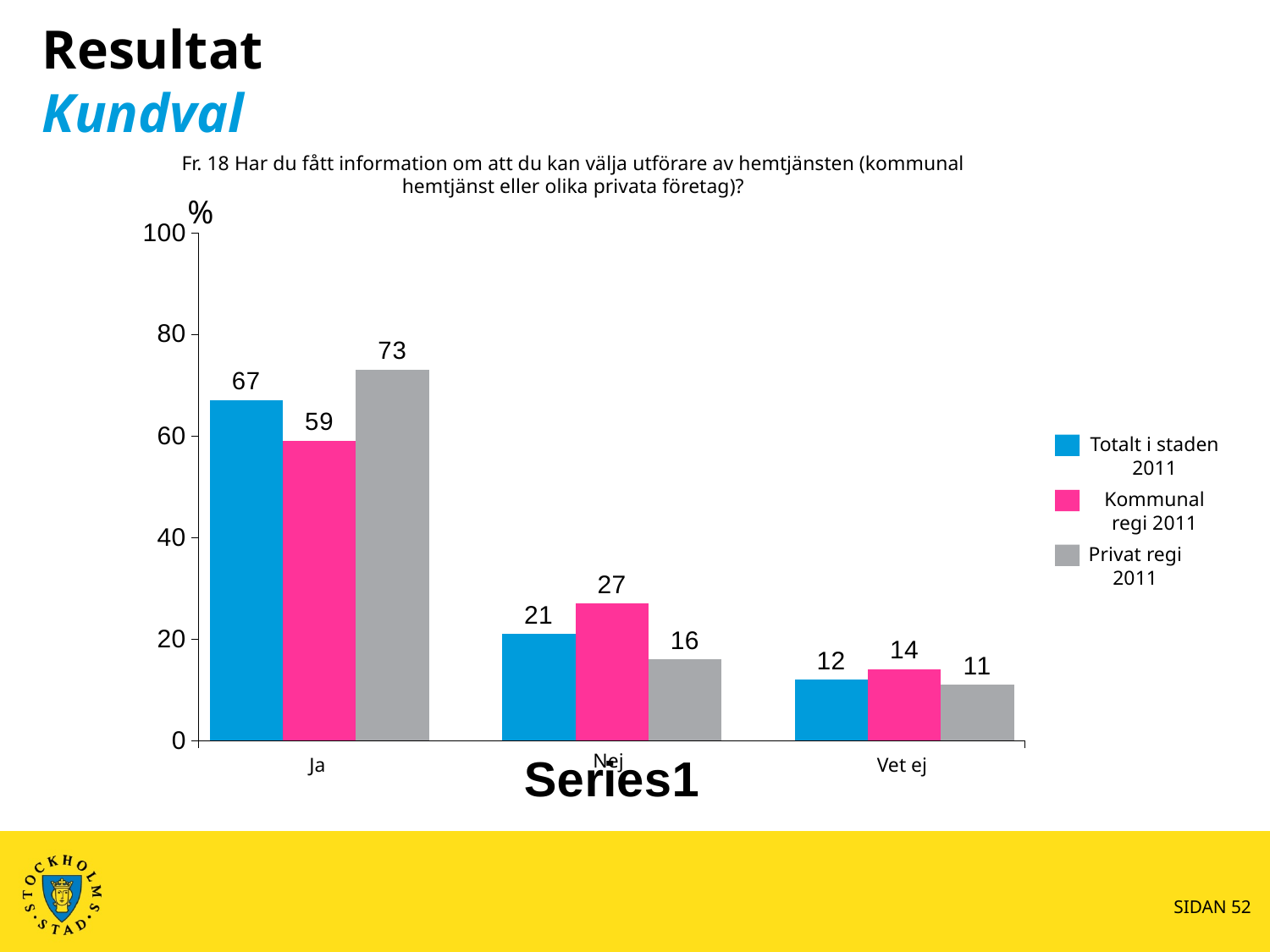
Which is larger in the Nej category: Totalt i staden 2011 or Kommunal regi 2011? Kommunal regi 2011 Which series has the highest value in the Ja category? Privat regi 2011 Is the value for Totalt i staden 2011 in the Ja category greater or less than 60? greater How many categories are shown on the x axis? 3 What is the difference between the Privat regi 2011 and Kommunal regi 2011 values in the Ja category? 14 How many series does the legend list? 3 What is the value for Privat regi 2011 in the Ja category? 73 What is the value for Kommunal regi 2011 in the Nej category? 27 What is the value for Totalt i staden 2011 in the Vet ej category? 12 Which series has the lowest value in the Vet ej category? Privat regi 2011 What colour represents Kommunal regi 2011 in the chart? pink What kind of chart is shown on the slide? bar chart